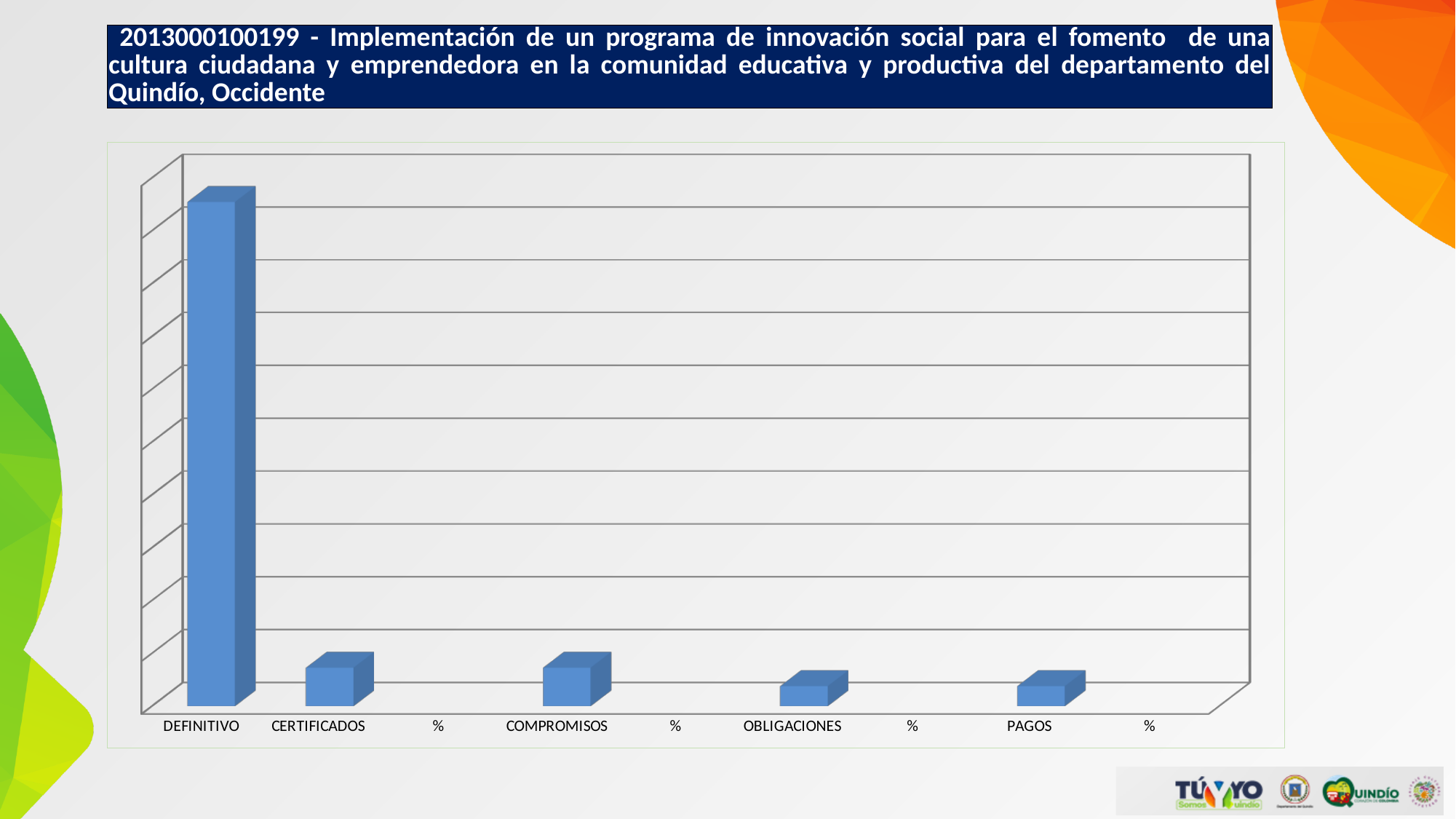
How many category labels are shown along the x axis of the chart? 9 What kind of chart is shown on the slide? bar chart Which bar is taller, DEFINITIVO or PAGOS? DEFINITIVO What is the label of the first category on the x axis? DEFINITIVO Which bar is taller, DEFINITIVO or CERTIFICADOS? DEFINITIVO What project code appears at the start of the slide title? 2013000100199 Which bar is taller, COMPROMISOS or PAGOS? COMPROMISOS How many visible bars does the chart have? 5 Which category has the tallest bar in the chart? DEFINITIVO